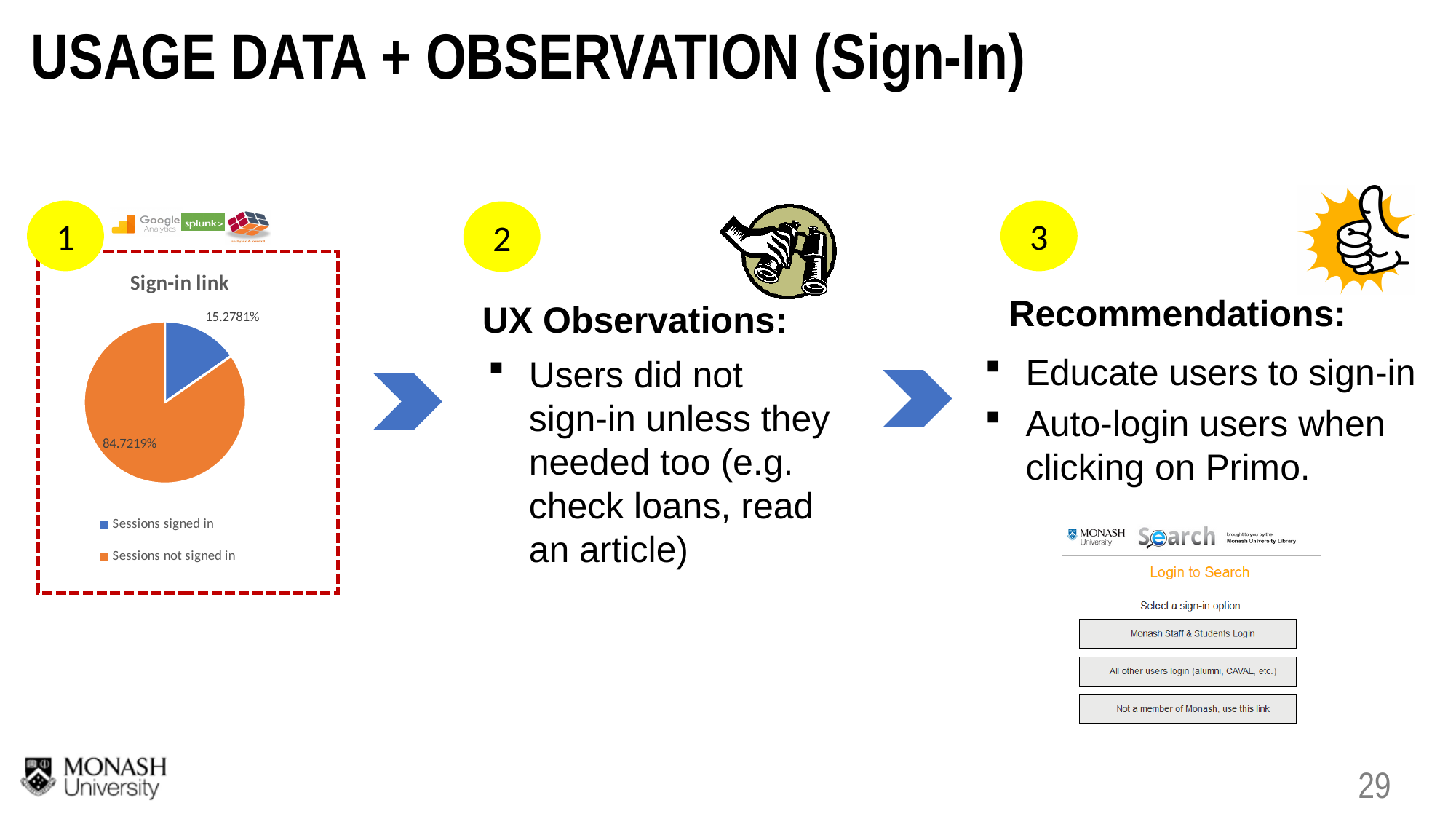
What colour represents Sessions not signed in in the pie chart? orange What percentage of sessions were signed in according to the pie chart? 15.2781% What is the difference in percentage points between Sessions not signed in and Sessions signed in? 69.4438 How many entries does the legend of the pie chart list? 2 Which is larger in the pie chart: Sessions signed in or Sessions not signed in? Sessions not signed in Which category has the largest slice in the pie chart? Sessions not signed in How many slices does the pie chart have? 2 What type of chart is shown under the title "Sign-in link"? pie chart What percentage of sessions were not signed in according to the pie chart? 84.7219% Which category has the smallest slice in the pie chart? Sessions signed in What is the title of the pie chart on the slide? Sign-in link